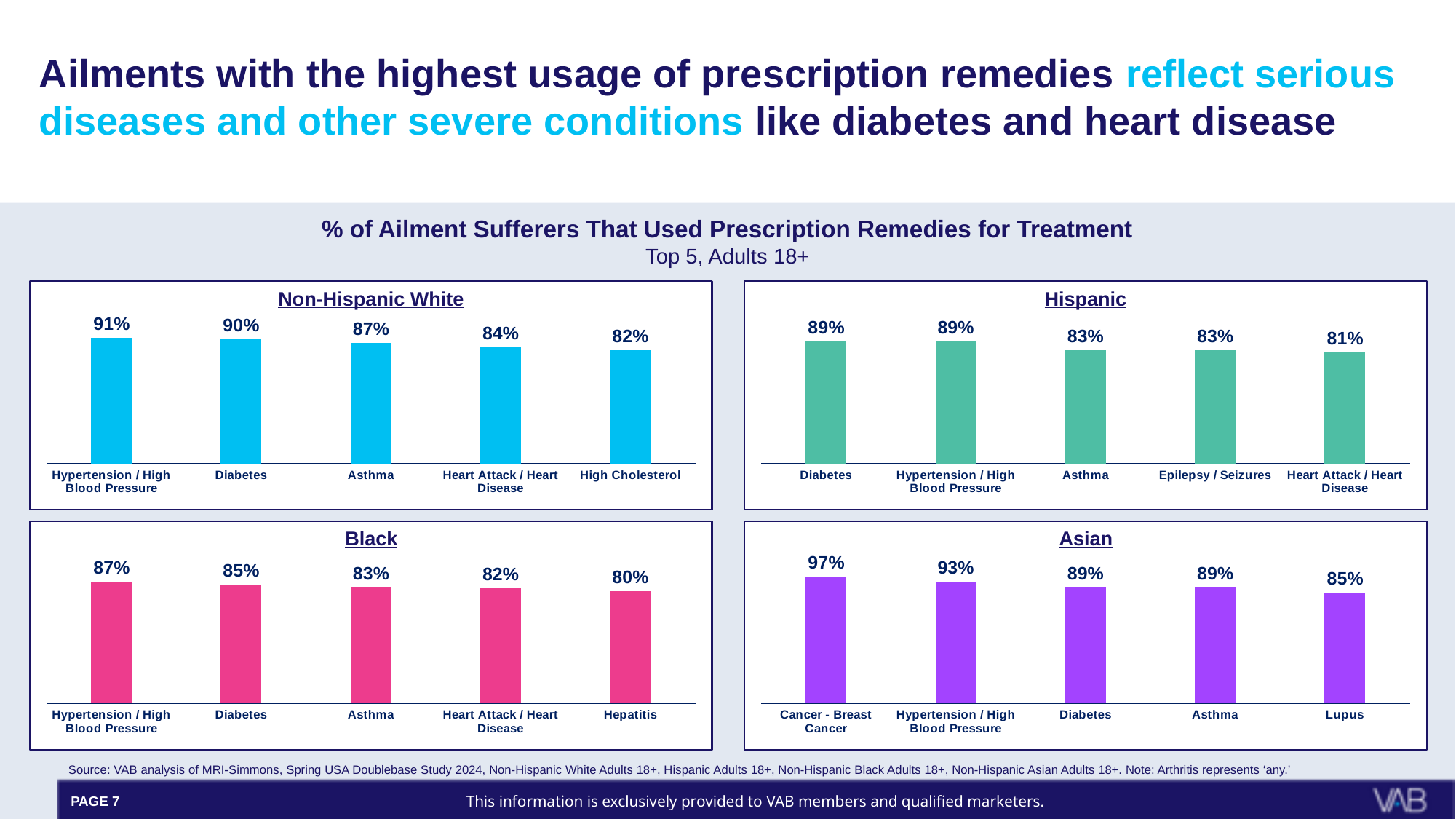
What colour are the bars in the Black chart? Pink In the Asian chart, what is the difference between Cancer - Breast Cancer and Lupus? 12% In the Asian chart, do the values rise or fall from left to right? Fall In the Hispanic chart, which is larger: Diabetes or Heart Attack / Heart Disease? Diabetes How many ailments are shown in the Black chart? 5 In the Asian chart, which ailment has the highest value? Cancer - Breast Cancer In the Non-Hispanic White chart, which ailment has the lowest value? High Cholesterol In the Black chart, what is the difference between Hypertension / High Blood Pressure and Heart Attack / Heart Disease? 5% In the Non-Hispanic White chart, what percentage of Hypertension / High Blood Pressure sufferers used prescription remedies? 91% What type of chart is the Hispanic chart? Bar chart In the Hispanic chart, what is the value for Epilepsy / Seizures? 83% In the Black chart, what is the value for Hepatitis? 80%